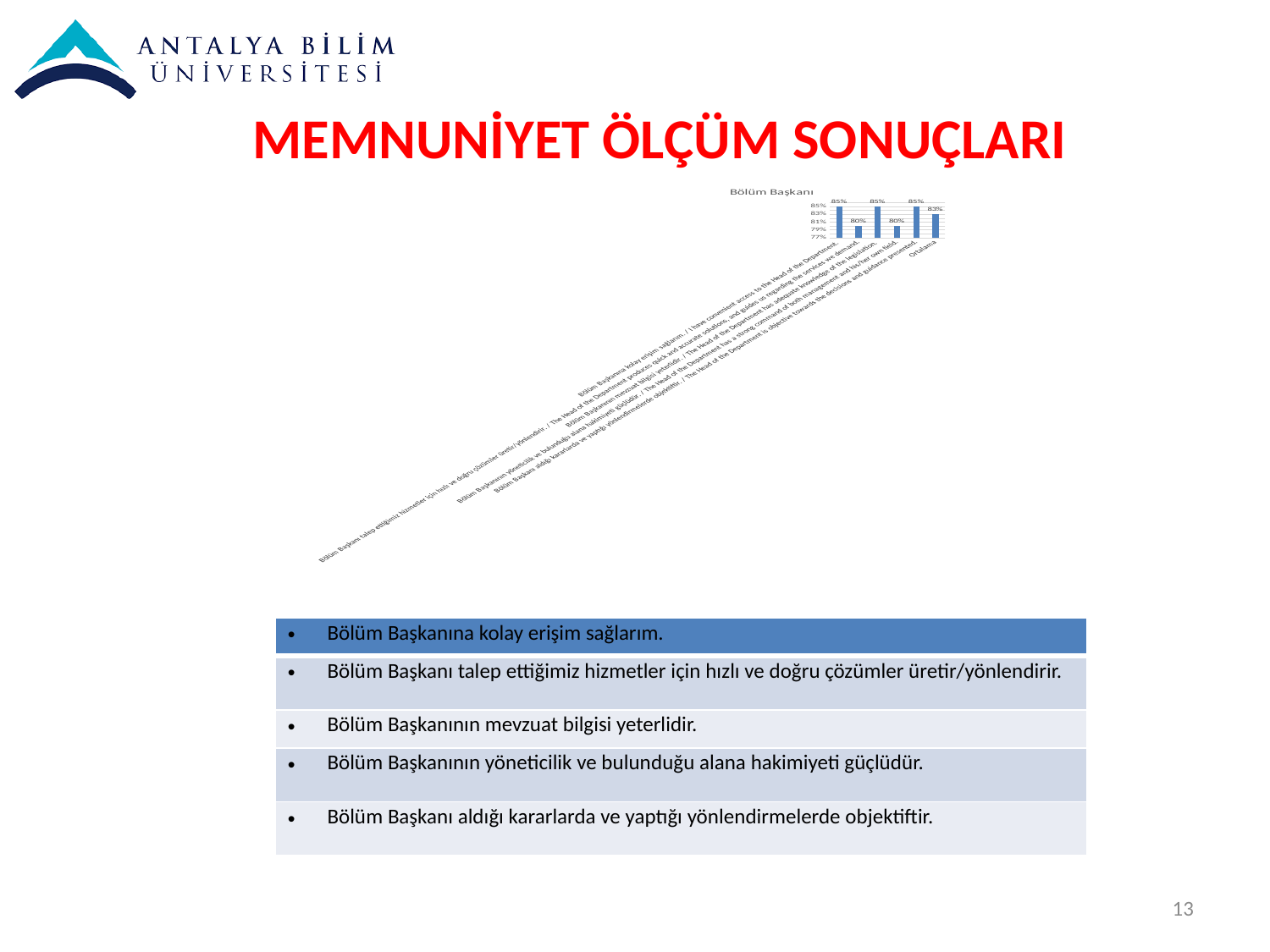
What is the highest tick value shown on the vertical axis of the chart? 85% Is the value of the first bar in the chart greater or less than 83%? greater How many bars in the chart have a value of 85%? 3 What kind of chart is shown on the slide? bar chart What is the difference between the highest bar value (85%) and the lowest bar value (80%) in the chart? 5 percentage points What is the title of the chart on the slide? Bölüm Başkanı Which is larger in the chart: the value of the first bar or the value of the second bar? the first bar What is the highest value shown by any bar in the chart? 85% How many bars does the chart show? 6 What is the lowest value shown by any bar in the chart? 80% Is the value of the Ortalama bar greater or less than 81%? greater What is the value of the Ortalama bar in the chart? 83%